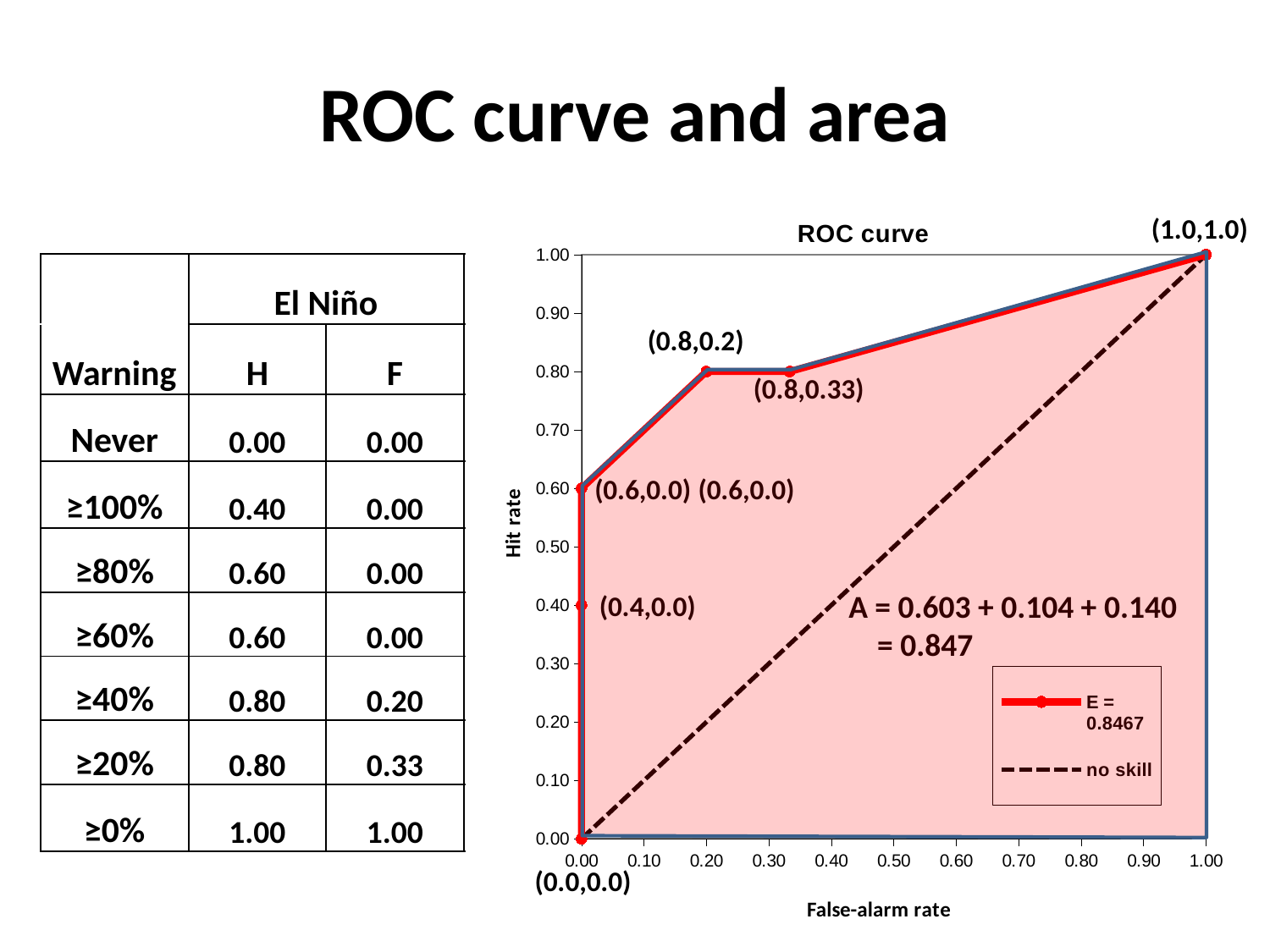
What kind of chart is shown on the slide? line chart What is the title of the chart on the slide? ROC curve On the ROC curve, what is the hit rate at a false-alarm rate of 0.33? 0.80 On the ROC curve, what is the hit rate at a false-alarm rate of 0.20? 0.80 How many series does the chart's legend list? 2 What value of the area A is stated on the chart? 0.847 What are the two entries in the chart's legend? E = 0.8467 and no skill At a false-alarm rate of 0.20, which is higher: the ROC curve or the no skill line? the ROC curve At a false-alarm rate of 0.50, is the hit rate of the no skill line greater or less than 0.60? less As the false-alarm rate increases along the x axis, does the hit rate of the ROC curve rise or fall? rise What is the highest hit rate reached by the ROC curve? 1.00 At a false-alarm rate of 0.50, is the hit rate of the ROC curve greater or less than 0.70? greater